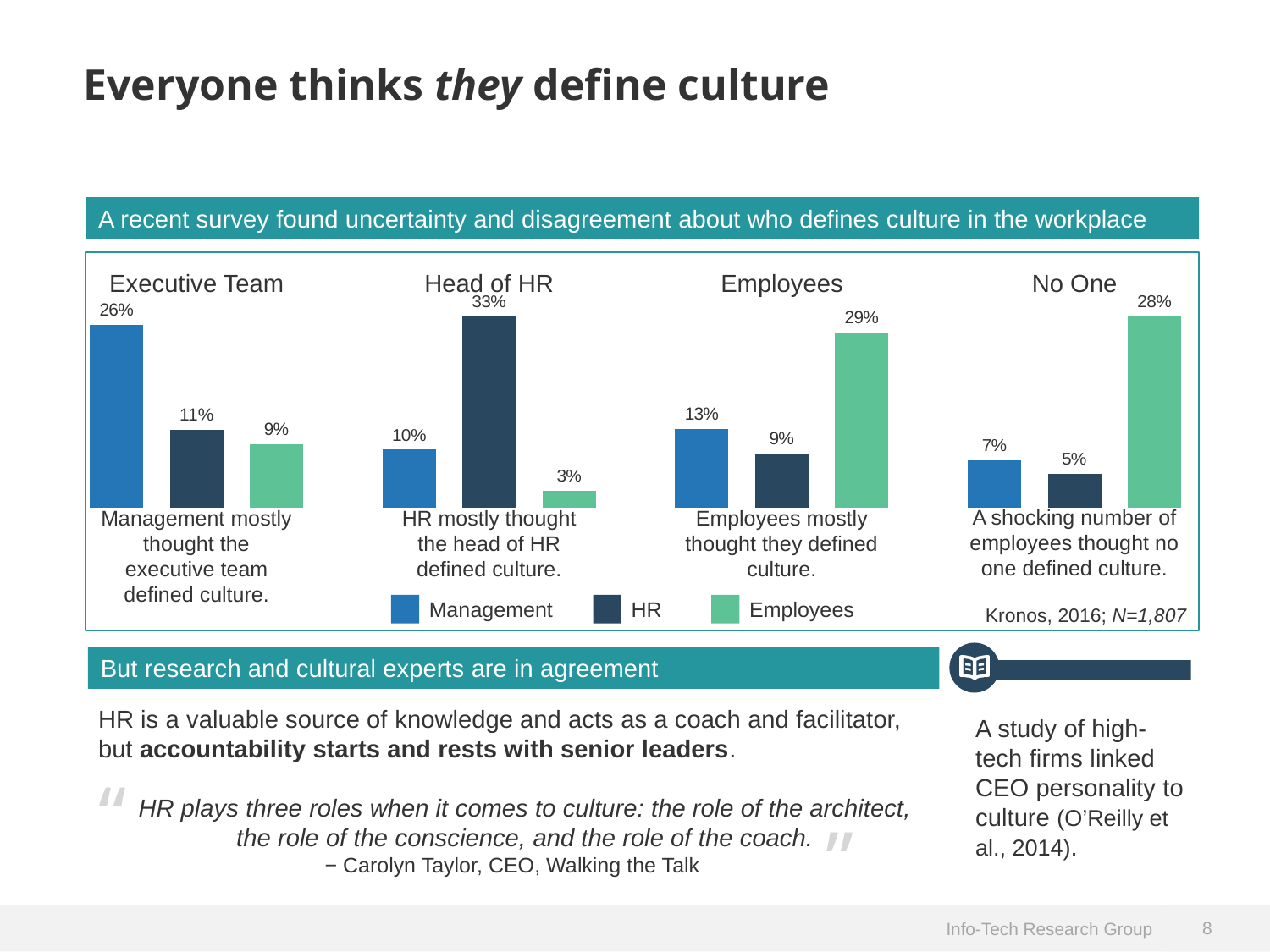
In the "Head of HR" chart, what is the difference between the HR value and the Management value? 23% In the "Executive Team" chart, what is the value for Management? 26% What kind of chart is the "No One" chart? Bar chart In the "Executive Team" chart, what is the difference between the Management value and the HR value? 15% How many series does the legend list for the charts? 3 In the "Employees" chart, what is the value for Employees? 29% In the "Employees" chart, which is larger, the Management value or the HR value? Management In the "Head of HR" chart, what is the value for HR? 33% In the "Head of HR" chart, which series has the lowest value? Employees In the "No One" chart, which series has the highest value? Employees In the "No One" chart, what is the value for HR? 5% What is the source cited for the charts? Kronos, 2016; N=1,807